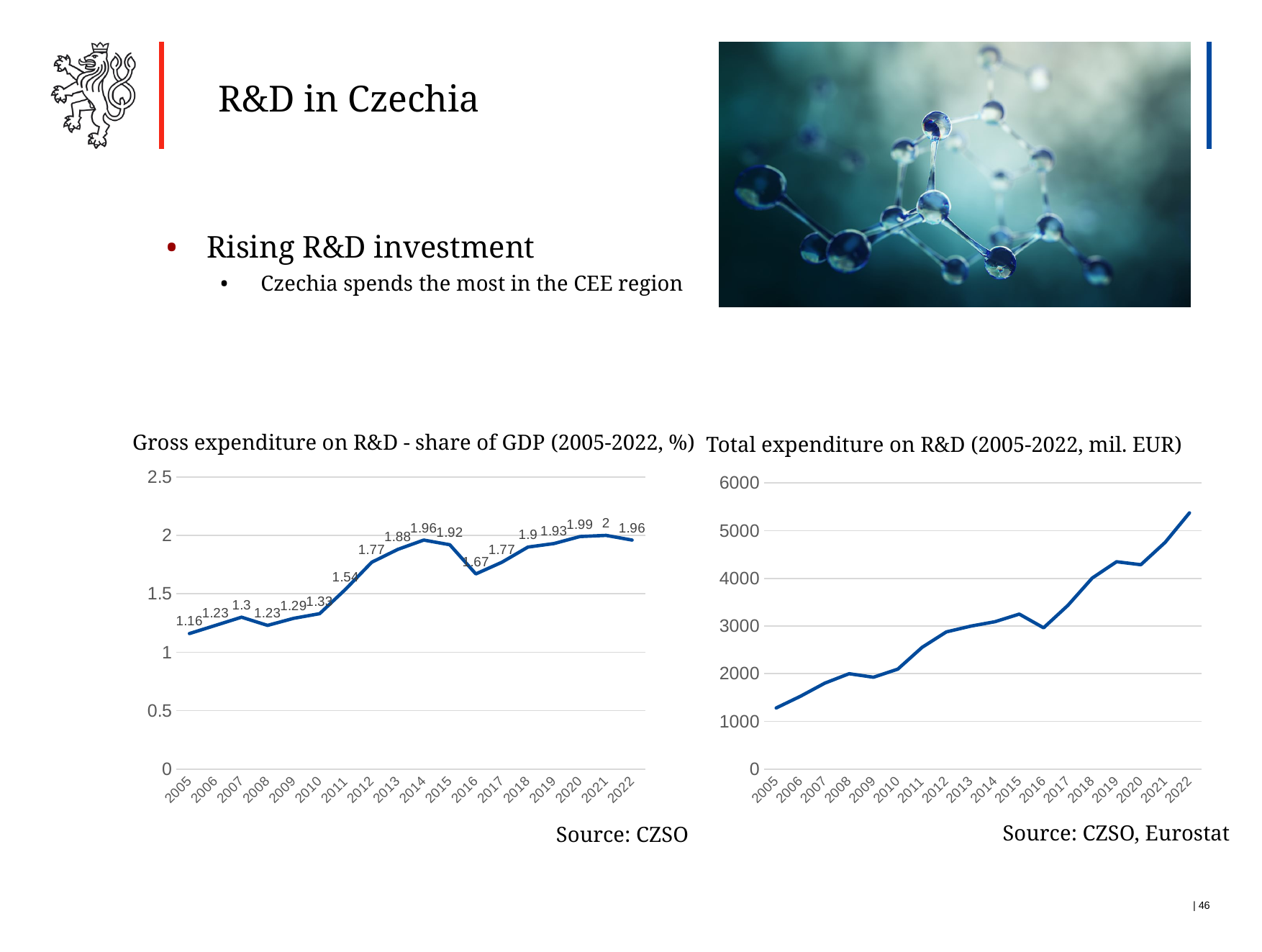
In the chart 'Total expenditure on R&D (2005-2022, mil. EUR)', is the value for 2011 greater or less than 3000? less In the chart 'Total expenditure on R&D (2005-2022, mil. EUR)', is the value for 2022 greater or less than 5000? greater In the chart 'Total expenditure on R&D (2005-2022, mil. EUR)', do the values generally rise or fall from 2005 to 2022? Rise In the chart 'Gross expenditure on R&D - share of GDP (2005-2022, %)', what is the value for 2016? 1.67 In the chart 'Gross expenditure on R&D - share of GDP (2005-2022, %)', what is the value for 2021? 2 In the chart 'Gross expenditure on R&D - share of GDP (2005-2022, %)', which year has the lowest value? 2005 In the chart 'Gross expenditure on R&D - share of GDP (2005-2022, %)', what is the difference between the values for 2022 and 2005? 0.8 How many years are plotted in the chart 'Gross expenditure on R&D - share of GDP (2005-2022, %)'? 18 What kind of chart is 'Total expenditure on R&D (2005-2022, mil. EUR)'? Line chart In the chart 'Gross expenditure on R&D - share of GDP (2005-2022, %)', which year has the larger value, 2015 or 2016? 2015 In the chart 'Gross expenditure on R&D - share of GDP (2005-2022, %)', which year has the highest value? 2021 In the chart 'Gross expenditure on R&D - share of GDP (2005-2022, %)', what is the value for 2005? 1.16